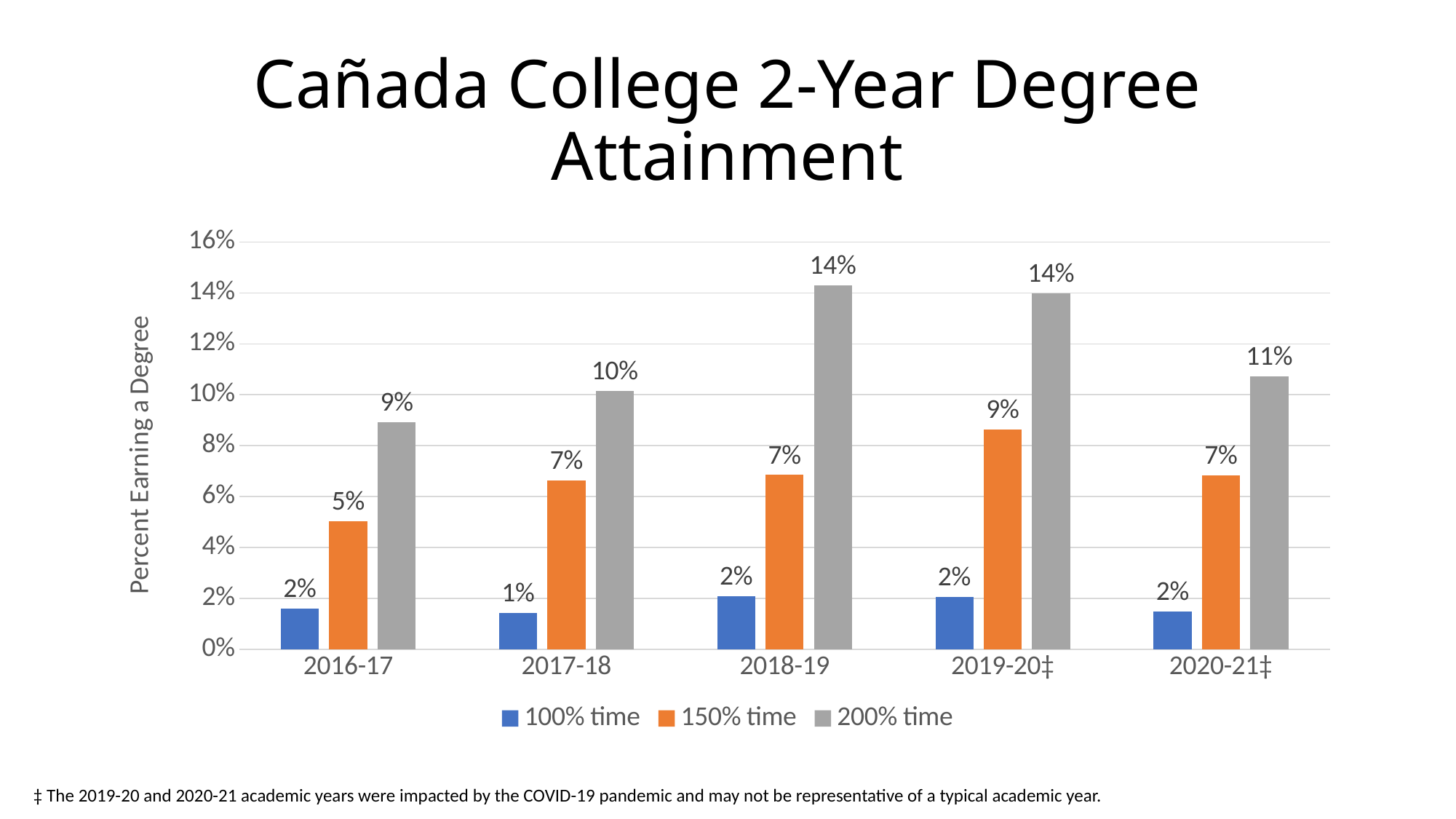
What is the difference between the 200% time values for 2020-21‡ and 2016-17? 2% What kind of chart is shown on the slide? Bar chart Which year has the lowest value for 200% time? 2016-17 What is the value for 100% time in 2017-18? 1% What is the value for 150% time in 2019-20‡? 9% What is the value for 200% time in 2018-19? 14% How many series does the legend list? 3 In 2019-20‡, what is the difference between the 200% time and 150% time values? 5% Does the 200% time value rise or fall from 2016-17 to 2018-19? Rise Which is larger: 150% time in 2016-17 or 150% time in 2017-18? 150% time in 2017-18 Which year has the highest value for 150% time? 2019-20‡ How many academic years are shown on the x axis? 5